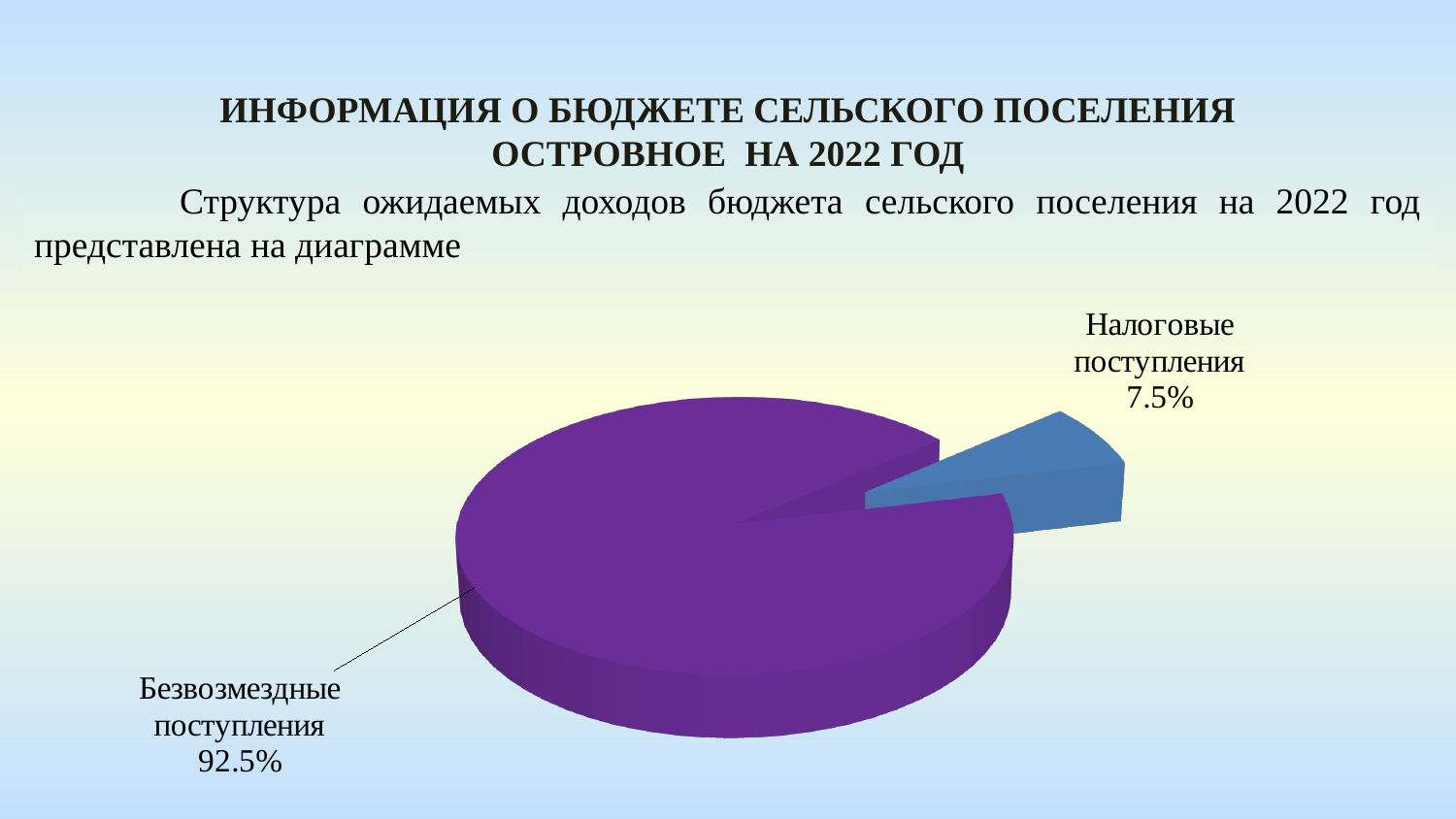
What share of the pie is labelled "Налоговые поступления"? 7.5% How many slices does the pie chart have? 2 Is the share for "Безвозмездные поступления" greater or less than 90%? greater What share of the pie is labelled "Безвозмездные поступления"? 92.5% Which is larger: "Налоговые поступления" or "Безвозмездные поступления"? Безвозмездные поступления What kind of chart is shown on the slide? Pie chart What is the difference in percentage points between "Безвозмездные поступления" and "Налоговые поступления"? 85 percentage points Is the share for "Налоговые поступления" greater or less than 10%? less Which slice of the pie is the largest? Безвозмездные поступления Which slice of the pie is the smallest? Налоговые поступления What colour is the slice for "Безвозмездные поступления"? Purple What colour is the slice for "Налоговые поступления"? Blue